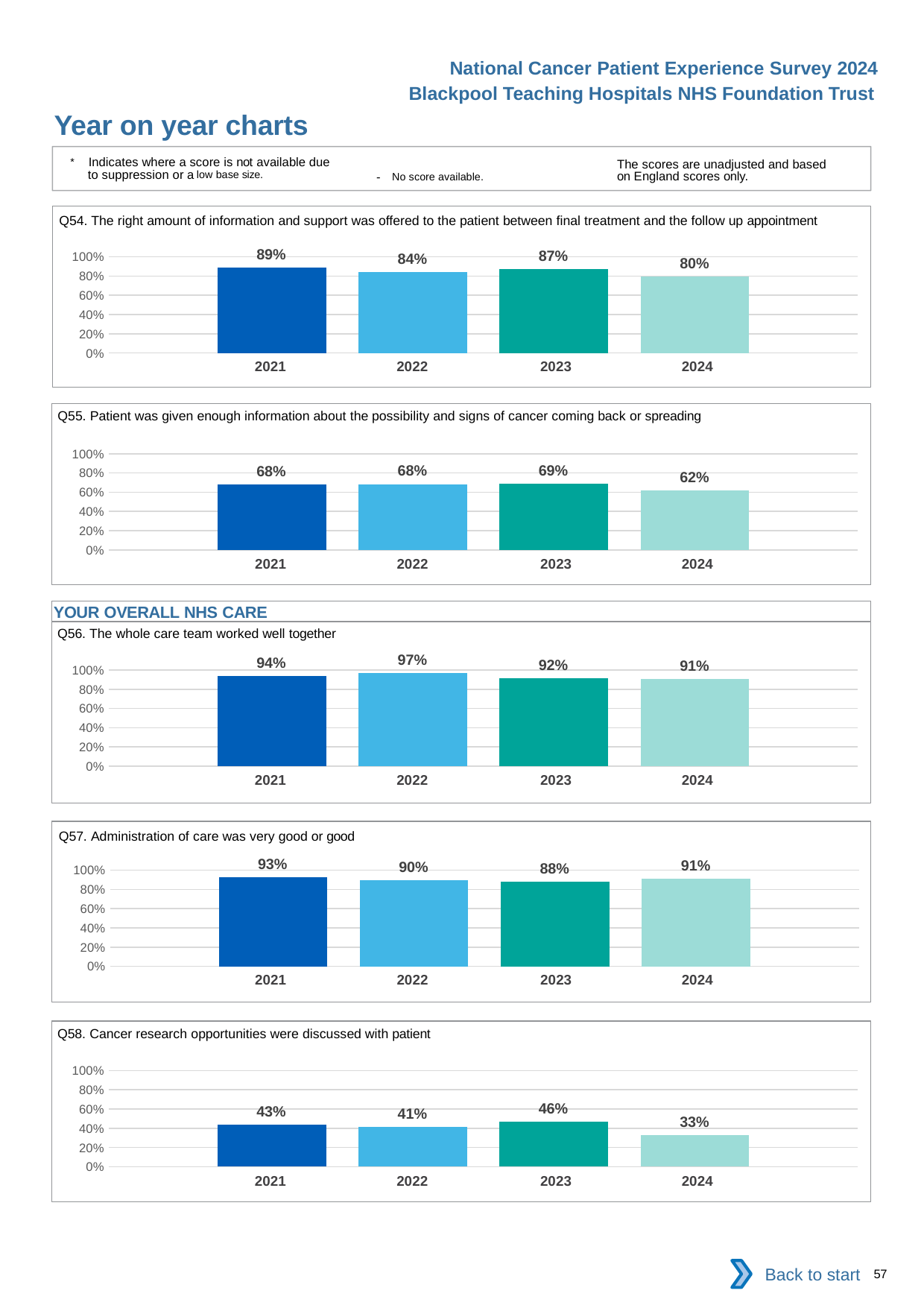
In the Q54 chart, what is the value for 2022? 84% How many years are shown in the Q58 chart? 4 In the Q54 chart, which year has the lowest value? 2024 In the Q57 chart, what is the difference between the 2021 and 2024 values? 2% In the Q57 chart, which is larger, the value for 2021 or the value for 2023? 2021 In the Q55 chart, what is the value for 2021? 68% In the Q55 chart, what is the difference between the 2023 and 2024 values? 7% In the Q58 chart, what is the value for 2023? 46% In the Q56 chart, which year has the highest value? 2022 In the Q58 chart, is the value for 2024 greater or less than 40%? less What type of chart is the Q54 chart? Bar chart In the Q56 chart, what is the value for 2024? 91%